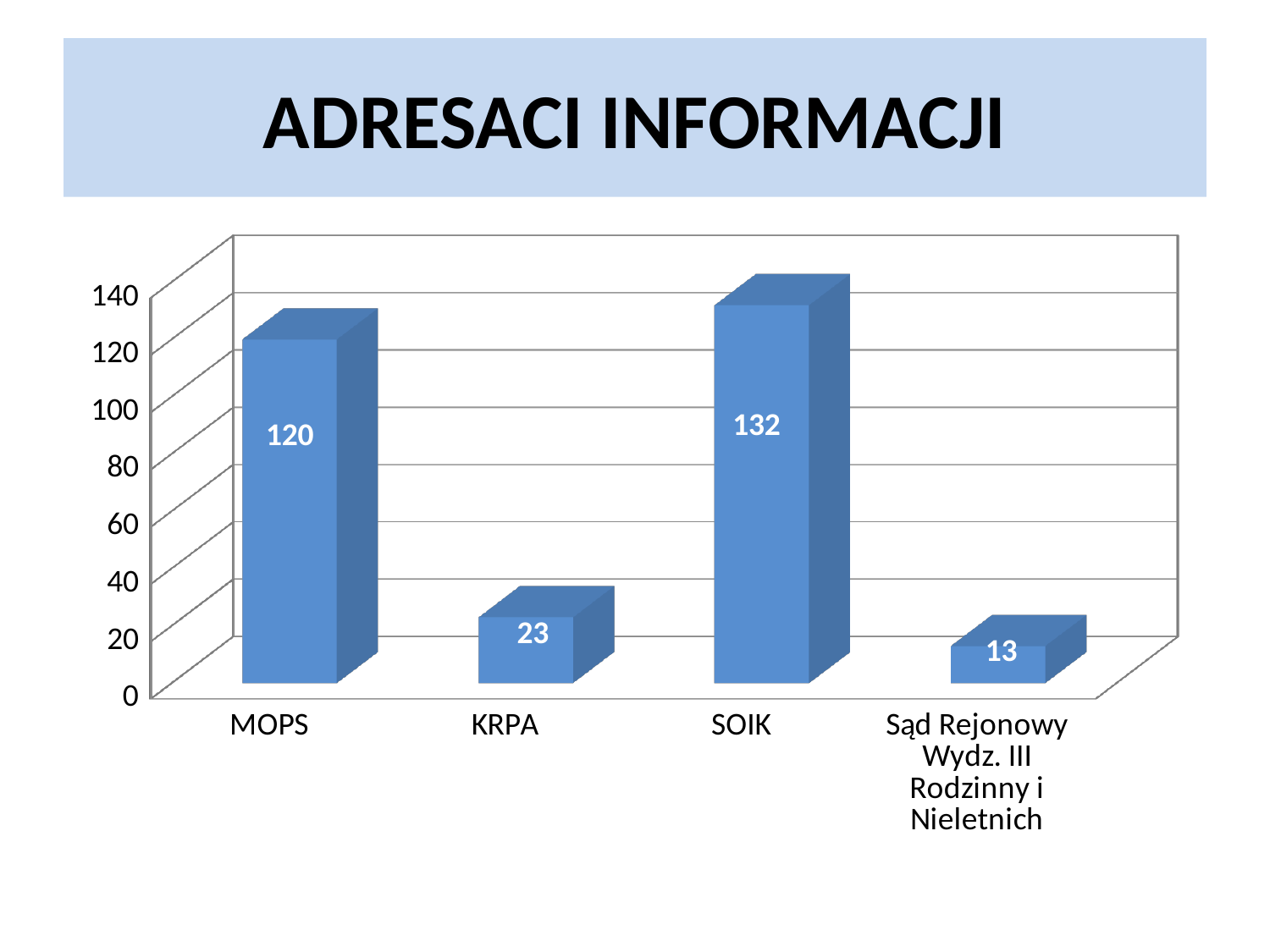
What kind of chart is shown on the slide? bar chart Which is larger, the value for MOPS or the value for KRPA? MOPS What is the difference between the values for KRPA and Sąd Rejonowy Wydz. III Rodzinny i Nieletnich? 10 Which category has the highest value? SOIK Which category has the lowest value? Sąd Rejonowy Wydz. III Rodzinny i Nieletnich What is the value for MOPS? 120 What is the value for SOIK? 132 What is the value for Sąd Rejonowy Wydz. III Rodzinny i Nieletnich? 13 How many categories are shown on the chart? 4 What is the title of the slide? ADRESACI INFORMACJI What is the value for KRPA? 23 What is the difference between the values for SOIK and MOPS? 12